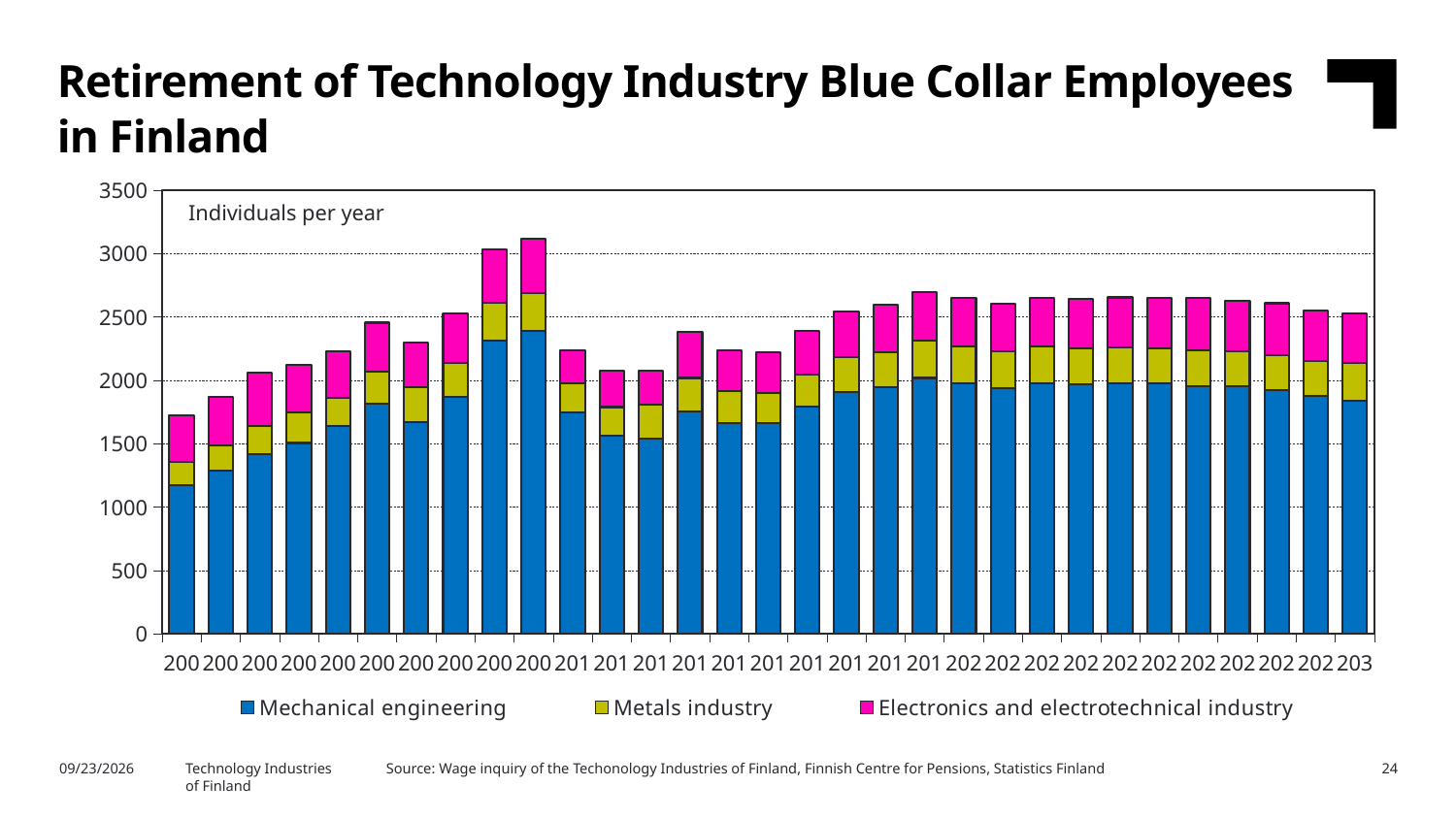
How many series does the legend list? 3 What is the title of the chart on the slide? Retirement of Technology Industry Blue Collar Employees in Finland Is the Mechanical engineering value in the first bar greater or less than 1500? less What kind of chart is shown on the slide? Stacked bar chart Which series forms the largest segment in every bar? Mechanical engineering Is the total of the tallest bar greater or less than 3000? greater Which series are listed in the legend? Mechanical engineering, Metals industry, Electronics and electrotechnical industry Which bar has the lowest total, the first bar or the last bar? The first bar Is the total of the first (leftmost) bar greater or less than 2000? less Do the bar totals rise or fall across the first five bars from the left? Rise How many bars are plotted in the chart? 31